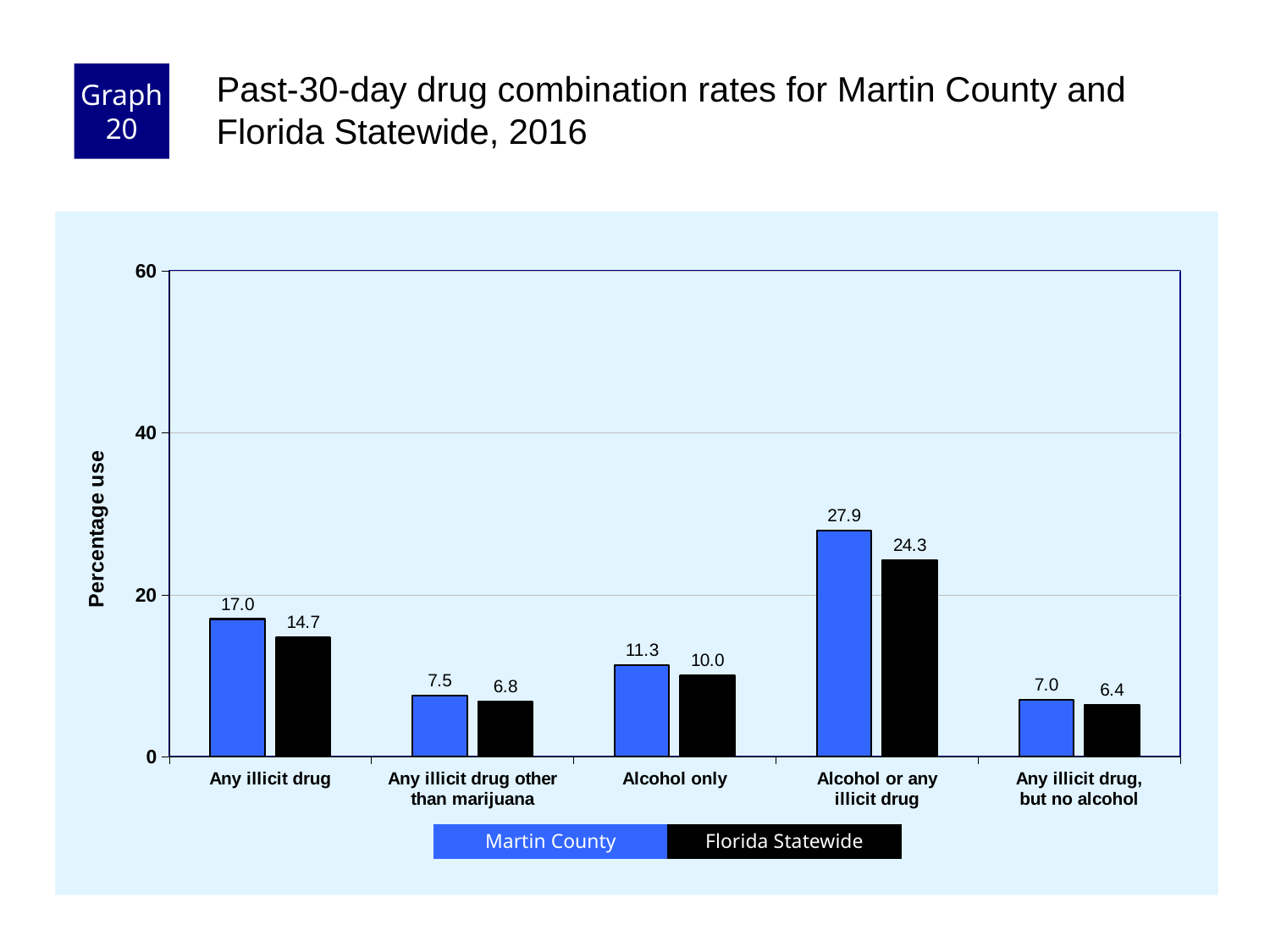
What is the difference between the Martin County and Florida Statewide values for Alcohol or any illicit drug? 3.6 How many categories are shown on the x axis? 5 Which category has the highest Martin County value? Alcohol or any illicit drug What kind of chart is shown on the slide? Bar chart What is the label of the y axis? Percentage use What is the Martin County value for Any illicit drug? 17.0 How many series does the legend list? 2 Is the Martin County value for Alcohol or any illicit drug greater or less than 20? greater What is the Florida Statewide value for Alcohol or any illicit drug? 24.3 What is the Florida Statewide value for Any illicit drug other than marijuana? 6.8 Which category has the lowest Florida Statewide value? Any illicit drug, but no alcohol Which is larger for Alcohol only: Martin County or Florida Statewide? Martin County